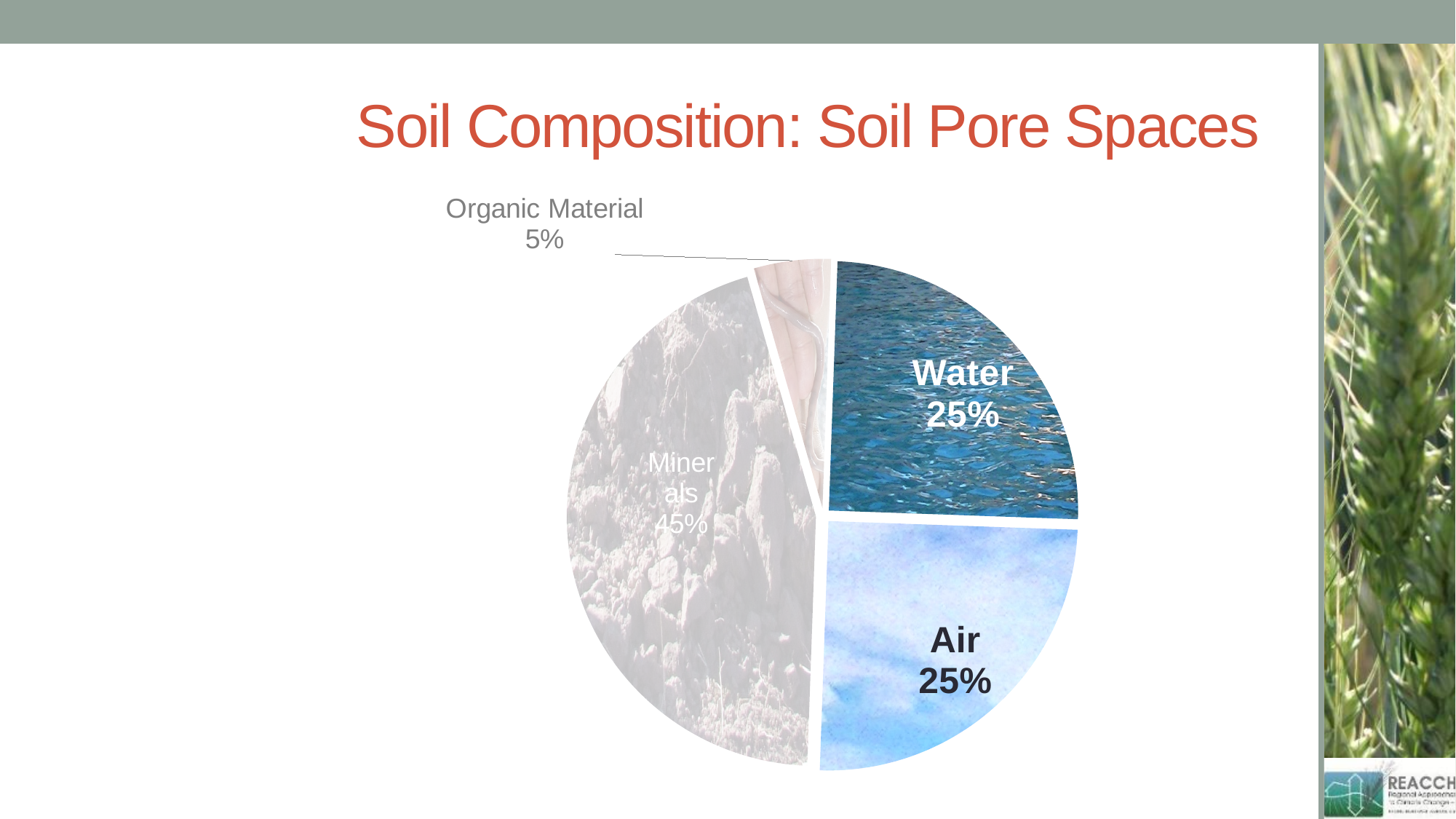
What percentage of the pie chart is labelled Minerals? 45% Which slice of the pie chart is the smallest? Organic Material How many slices does the pie chart have? 4 Which is larger in the pie chart, Minerals or Air? Minerals What percentage of the pie chart is labelled Water? 25% What is the title of the slide containing the chart? Soil Composition: Soil Pore Spaces What kind of chart is shown on the slide? Pie chart What is the difference between the Air share and the Organic Material share in the pie chart? 20% Which slice of the pie chart is the largest? Minerals What percentage of the pie chart is labelled Air? 25% What percentage of the pie chart is labelled Organic Material? 5% What is the difference between the Minerals share and the Water share in the pie chart? 20%